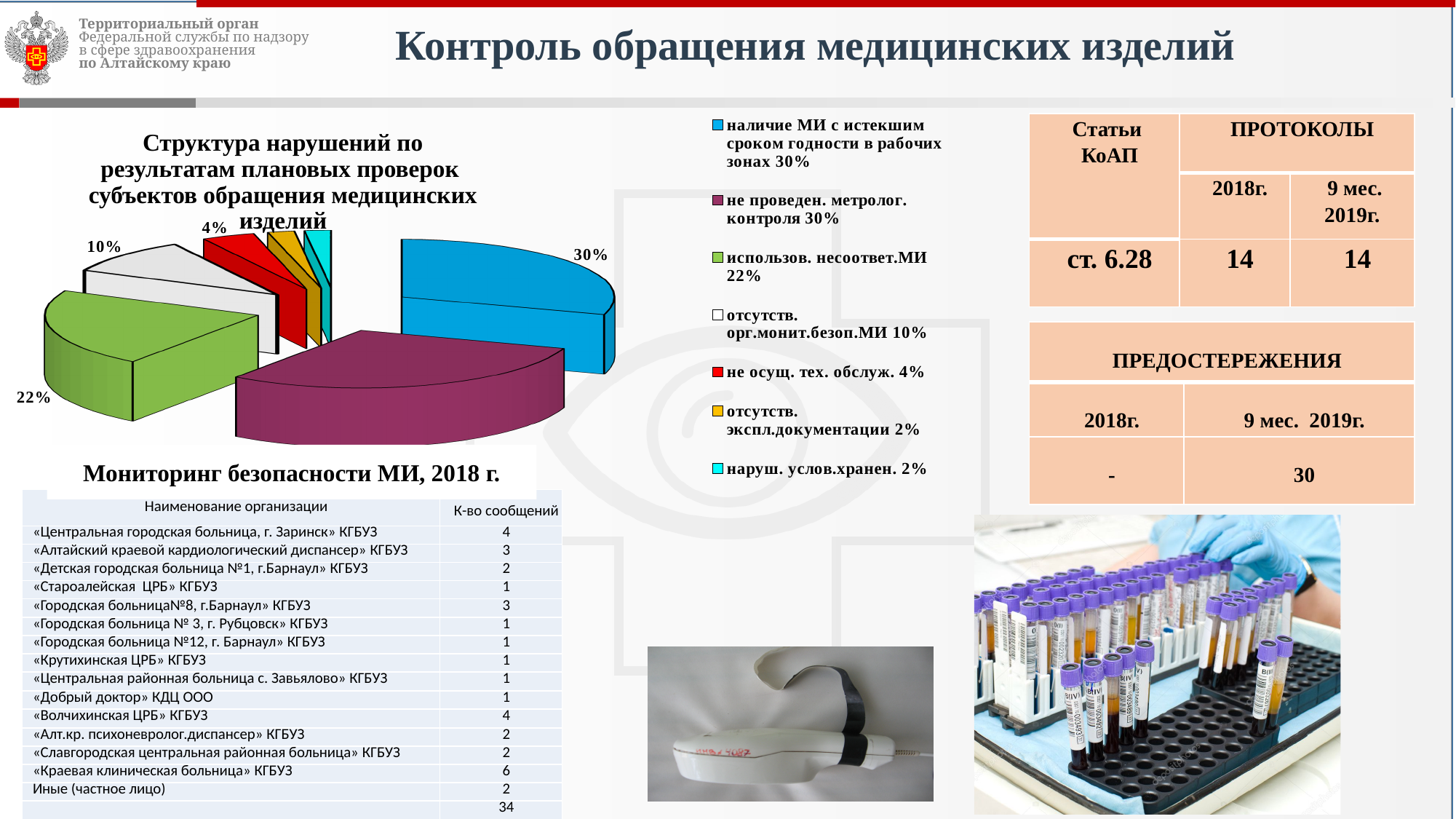
What kind of chart is shown on the slide? pie chart What colour is the slice representing "использов. несоответ.МИ" in the pie chart? green What share of violations is attributed to "использов. несоответ.МИ" in the pie chart? 22% What share of violations is attributed to "не осущ. тех. обслуж." in the pie chart? 4% What share of violations is attributed to "не проведен. метролог. контроля" in the pie chart? 30% What share of violations is attributed to "наруш. услов.хранен." in the pie chart? 2% How many entries does the legend of the pie chart list? 7 What share of violations is attributed to "отсутств. орг.монит.безоп.МИ" in the pie chart? 10% How many slices does the pie chart have? 7 What is the difference in percentage points between the share for "использов. несоответ.МИ" and the share for "отсутств. орг.монит.безоп.МИ"? 12 Which category has the smallest share in the pie chart, "использов. несоответ.МИ" or "отсутств. орг.монит.безоп.МИ"? отсутств. орг.монит.безоп.МИ What is the difference in percentage points between the share for "наличие МИ с истекшим сроком годности в рабочих зонах" and the share for "не осущ. тех. обслуж."? 26